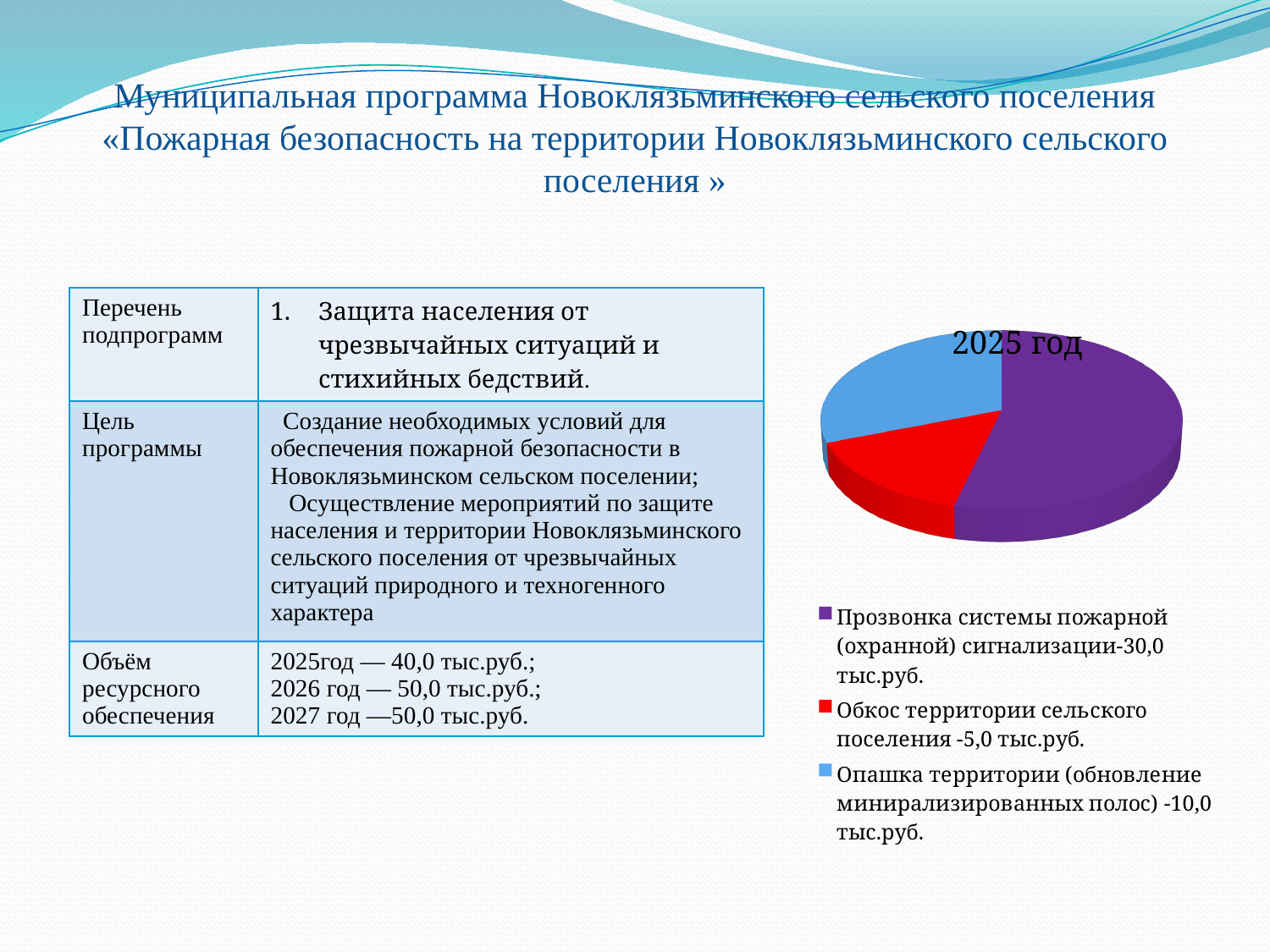
Which is larger: the value for «Опашка территории» or the value for «Обкос территории сельского поселения»? Опашка территории Which category has the smallest slice in the pie chart? Обкос территории сельского поселения What kind of chart is shown on the slide? pie chart Which category has the largest slice in the pie chart? Прозвонка системы пожарной (охранной) сигнализации What value is given for «Прозвонка системы пожарной (охранной) сигнализации» in the pie chart legend? 30,0 тыс.руб. What value is given for «Обкос территории сельского поселения» in the pie chart legend? 5,0 тыс.руб. What is the title of the pie chart? 2025 год How many entries does the legend of the pie chart list? 3 What value is given for «Опашка территории (обновление минирализированных полос)» in the pie chart legend? 10,0 тыс.руб. What is the difference between the value for «Прозвонка системы пожарной (охранной) сигнализации» and the value for «Обкос территории сельского поселения»? 25,0 тыс.руб. What colour is the slice for «Обкос территории сельского поселения» in the pie chart? red How many slices does the pie chart have? 3